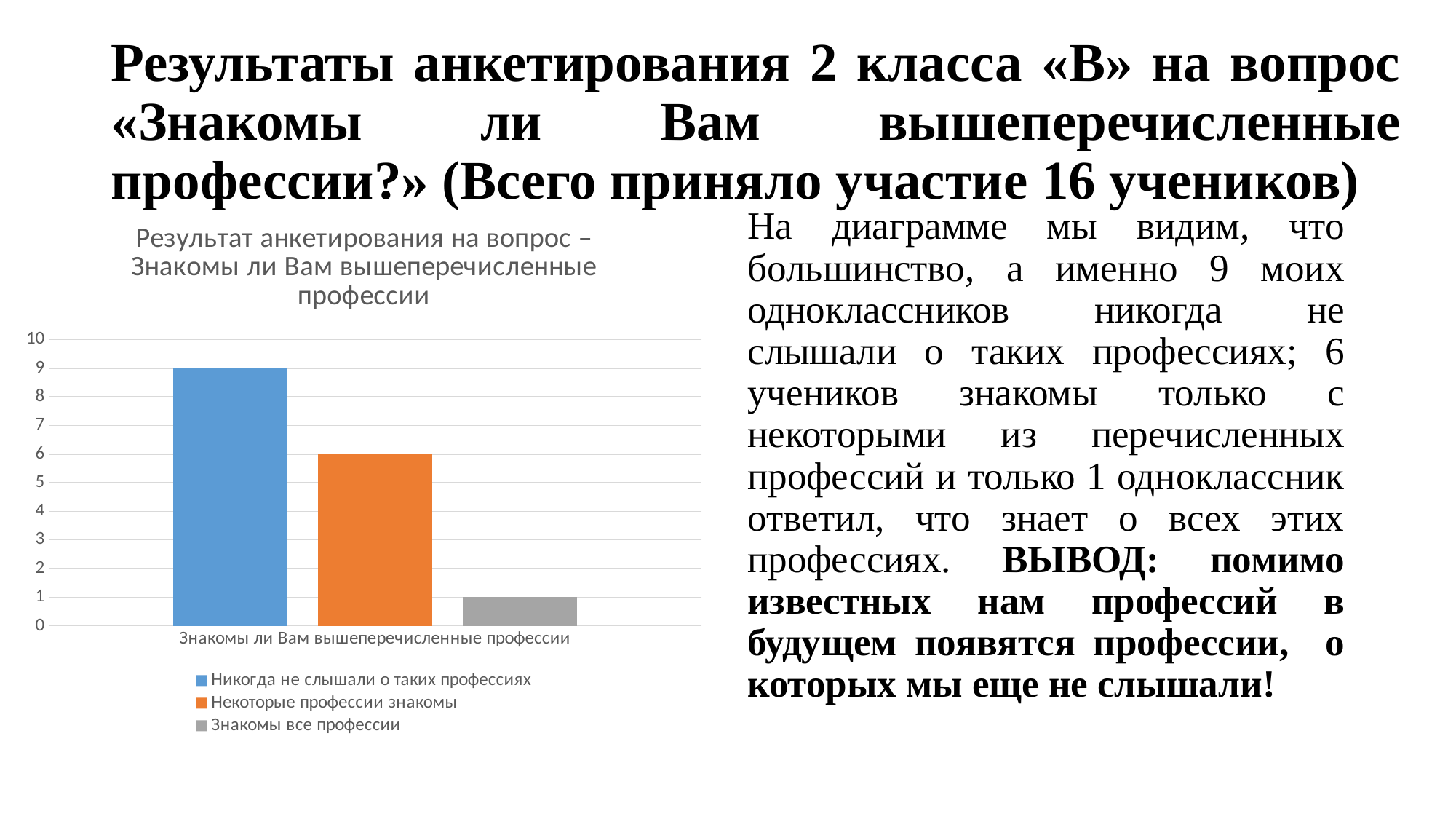
Which series has the highest value in the chart? Никогда не слышали о таких профессиях What is the value for the series "Некоторые профессии знакомы"? 6 What is the value for the series "Никогда не слышали о таких профессиях"? 9 Is the value for "Никогда не слышали о таких профессиях" greater or less than 5? greater What is the maximum value shown on the chart's vertical axis? 10 What is the difference between the values for "Никогда не слышали о таких профессиях" and "Некоторые профессии знакомы"? 3 What colour is the bar for "Некоторые профессии знакомы"? Orange What is the value for the series "Знакомы все профессии"? 1 What kind of chart is shown on the slide? Bar chart Which series has the lowest value in the chart? Знакомы все профессии Which is larger: the value for "Некоторые профессии знакомы" or the value for "Знакомы все профессии"? Некоторые профессии знакомы How many series does the chart legend list? 3